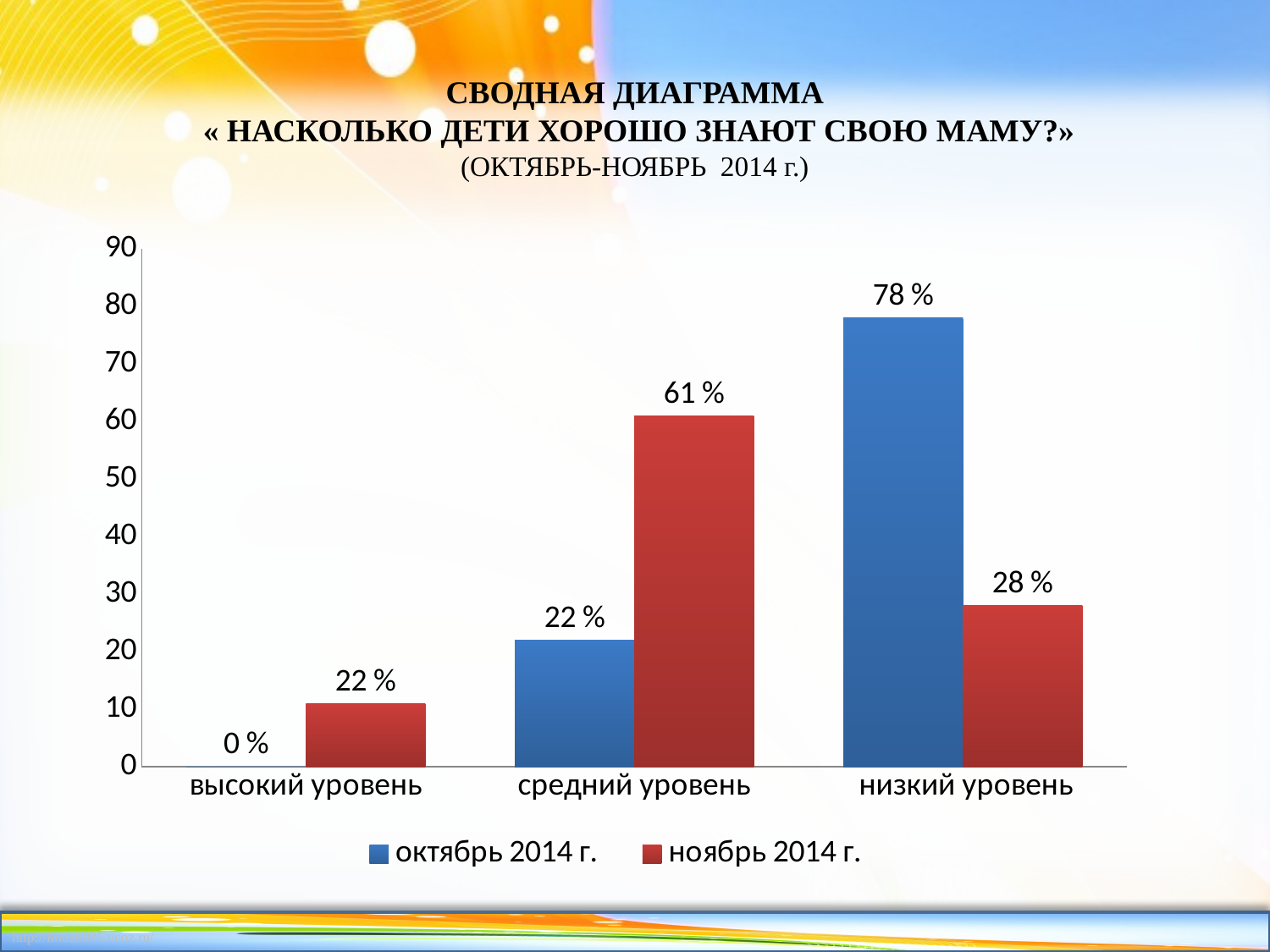
How many categories are shown on the x axis? 3 What is the value for высокий уровень in the октябрь 2014 г. series? 0 % What kind of chart is shown on the slide? bar chart For средний уровень, which series has the larger value, октябрь 2014 г. or ноябрь 2014 г.? ноябрь 2014 г. Which category has the highest value in the октябрь 2014 г. series? низкий уровень Which category has the lowest value in the октябрь 2014 г. series? высокий уровень How many series does the legend list? 2 What is the difference between the октябрь 2014 г. and ноябрь 2014 г. values for низкий уровень? 50 % What is the value for низкий уровень in the ноябрь 2014 г. series? 28 % What is the value for низкий уровень in the октябрь 2014 г. series? 78 % What is the value for средний уровень in the ноябрь 2014 г. series? 61 % Which category has the highest value in the ноябрь 2014 г. series? средний уровень